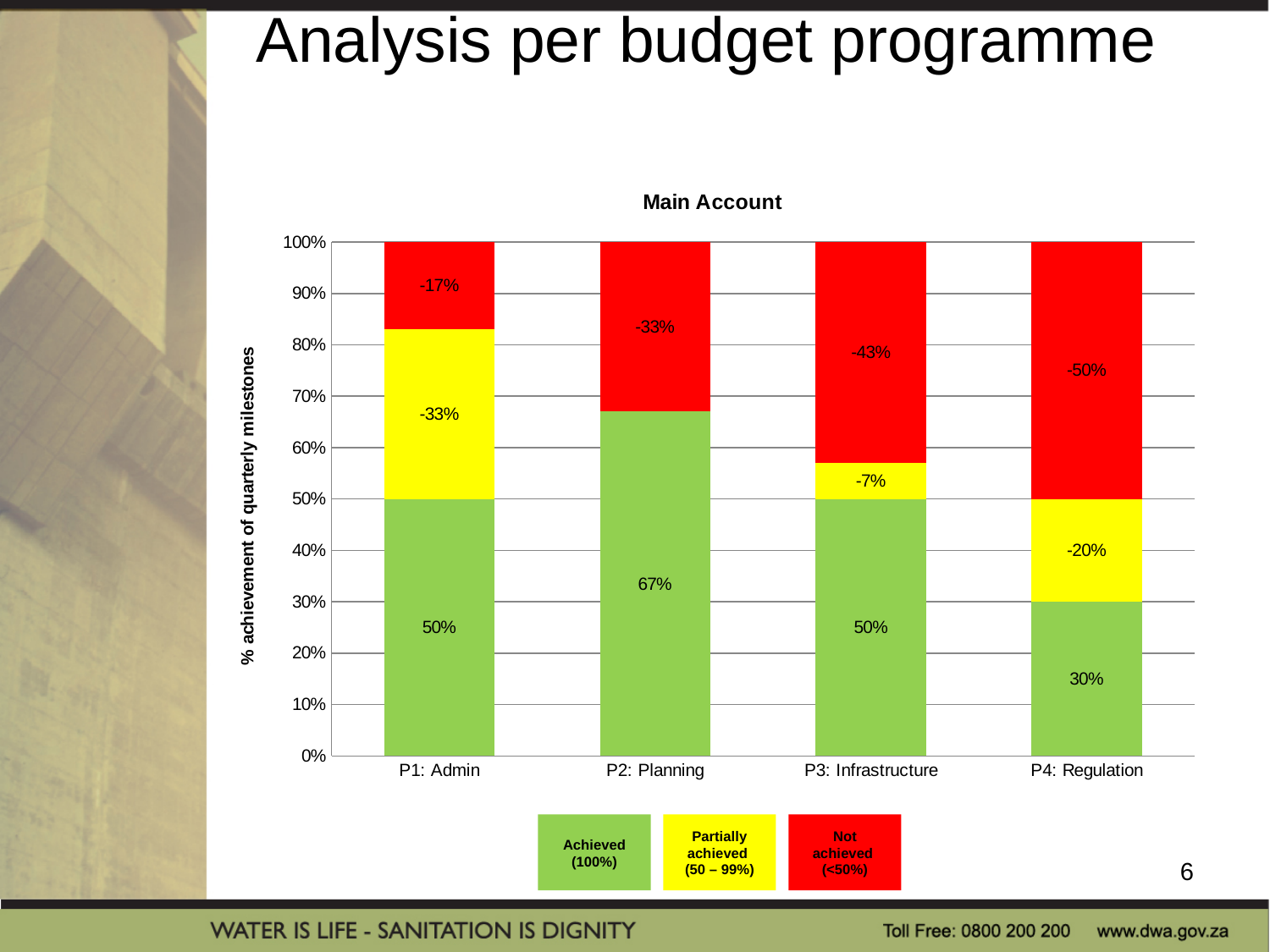
Which budget programme has the highest Achieved (green) value? P2: Planning Which budget programme has the largest red (Not achieved) segment? P4: Regulation What type of chart is shown on the slide? Stacked bar chart Is the Achieved value for P2: Planning larger or smaller than the Achieved value for P3: Infrastructure? larger What is the difference between the Achieved values for P2: Planning and P4: Regulation? 37% What is the Achieved value for P2: Planning? 67% What is the Achieved value for P4: Regulation? 30% What label is printed on the red (Not achieved) segment for P3: Infrastructure? -43% Which budget programme has the lowest Achieved (green) value? P4: Regulation How many budget programmes are shown on the x axis? 4 How many series does the legend list? 3 What label is printed on the yellow (Partially achieved) segment for P1: Admin? -33%